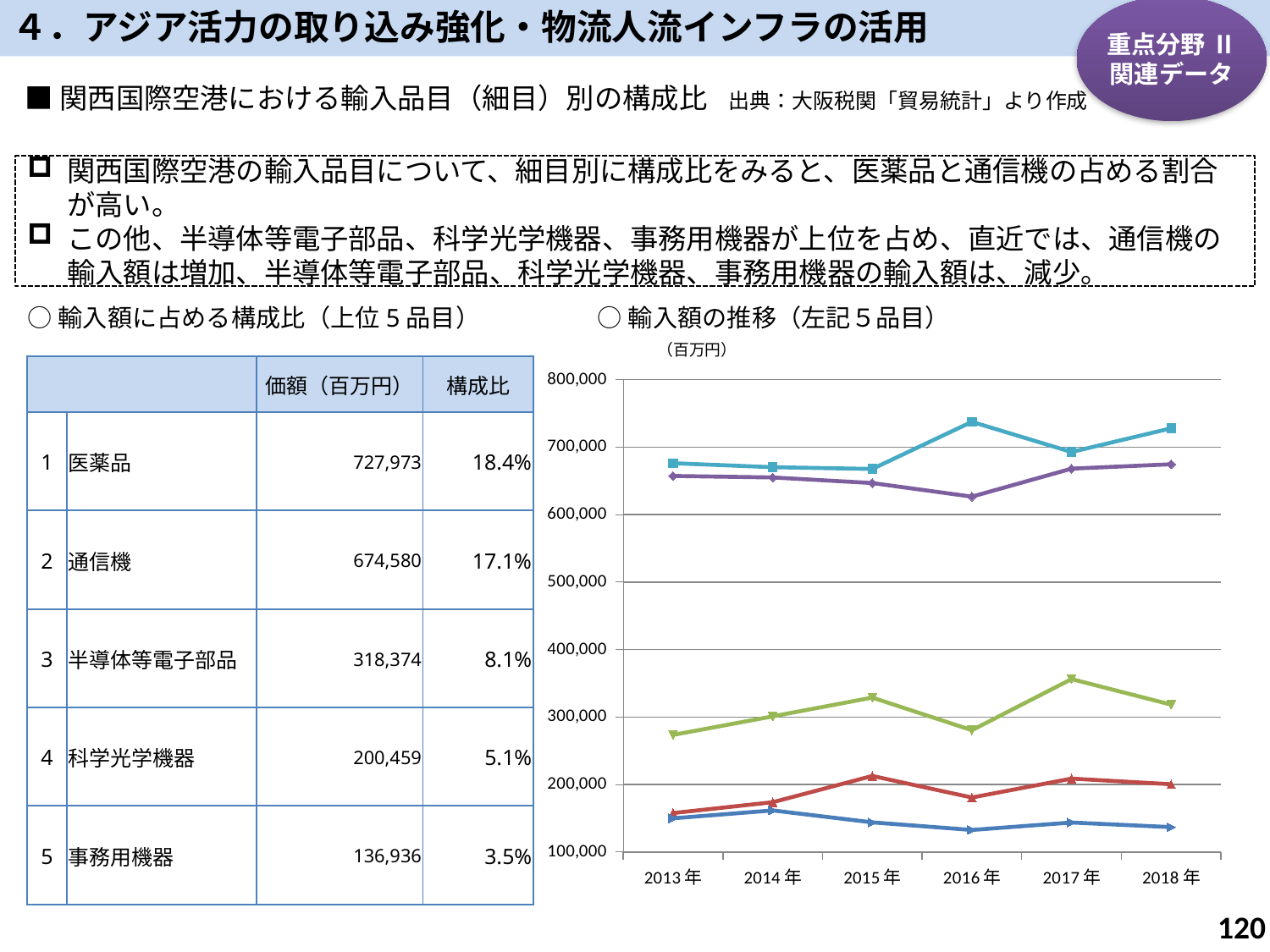
In the line chart, does the green line rise or fall from 2013年 to 2015年? rise What kind of chart is shown on the right side of the slide under 輸入額の推移（左記５品目）? line chart In the line chart, is the value of the dark blue line in 2018年 greater or less than 200,000? less What unit is shown above the y axis of the line chart? 百万円 In the line chart, in which year does the green line reach its highest point? 2017年 How many years are shown along the x axis of the line chart? 6 In the line chart, is the value of the green line in 2017年 greater or less than 300,000? greater In the line chart, is the value of the purple line in 2016年 greater or less than 700,000? less How many lines are plotted in the line chart? 5 In the line chart, which is higher in 2016年, the light blue line or the purple line? the light blue line In the line chart, in which year does the light blue line reach its highest point? 2016年